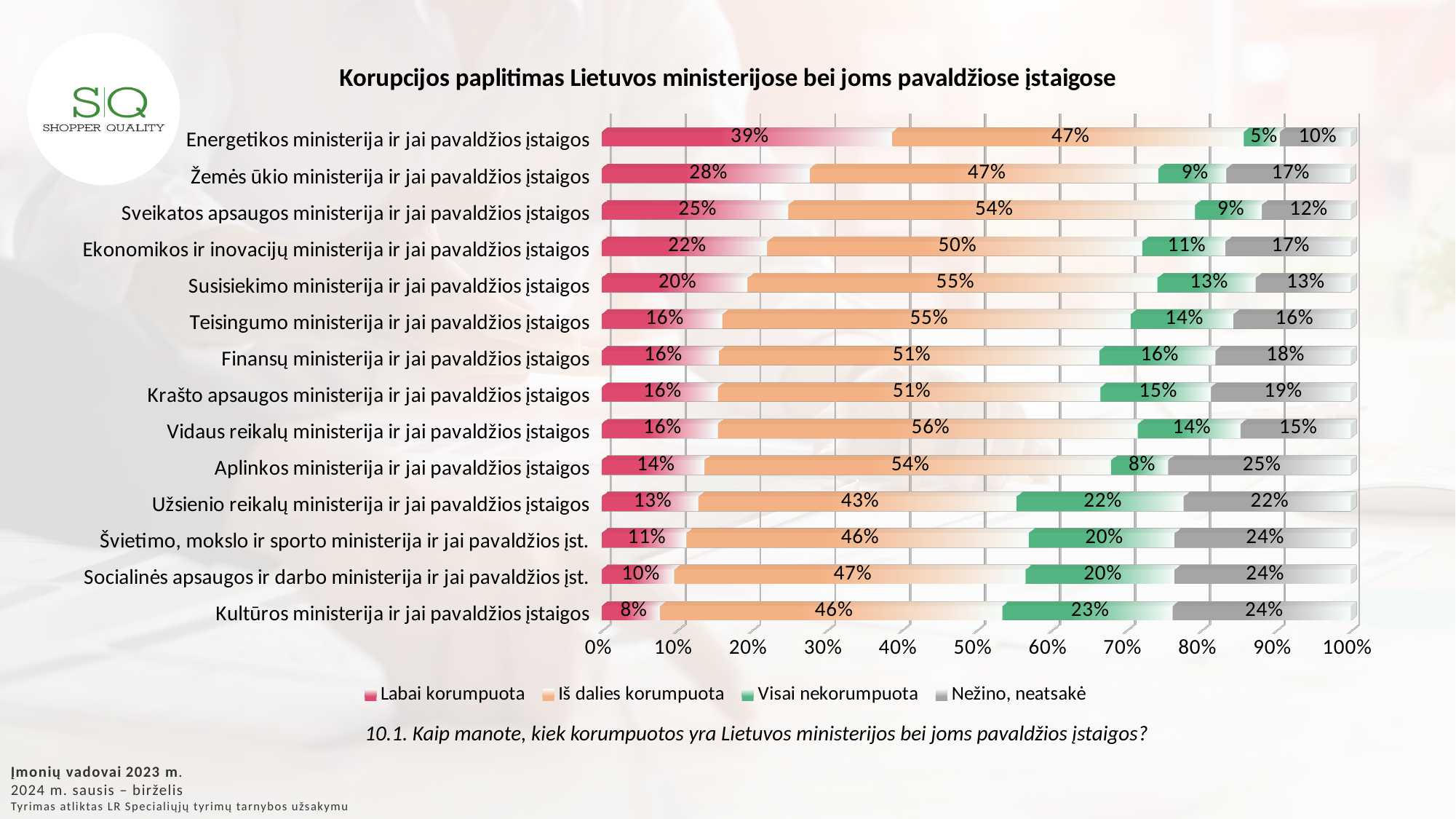
How many categories (ministries) are shown in the chart? 14 What is the 'Labai korumpuota' value for Energetikos ministerija ir jai pavaldžios įstaigos? 39% Which category has the lowest 'Labai korumpuota' value? Kultūros ministerija ir jai pavaldžios įstaigos What is the 'Iš dalies korumpuota' value for Vidaus reikalų ministerija ir jai pavaldžios įstaigos? 56% What type of chart is shown on the slide? Stacked bar chart Which is larger: the 'Visai nekorumpuota' value for Užsienio reikalų ministerija or for Švietimo, mokslo ir sporto ministerija? Užsienio reikalų ministerija ir jai pavaldžios įstaigos What is the 'Nežino, neatsakė' value for Aplinkos ministerija ir jai pavaldžios įstaigos? 25% What is the 'Visai nekorumpuota' value for Kultūros ministerija ir jai pavaldžios įstaigos? 23% Which category has the highest 'Labai korumpuota' value? Energetikos ministerija ir jai pavaldžios įstaigos How many series does the legend list? 4 What is the total of the stacked bar for Sveikatos apsaugos ministerija ir jai pavaldžios įstaigos? 100% What is the difference between the 'Labai korumpuota' values for Energetikos ministerija and Žemės ūkio ministerija? 11%